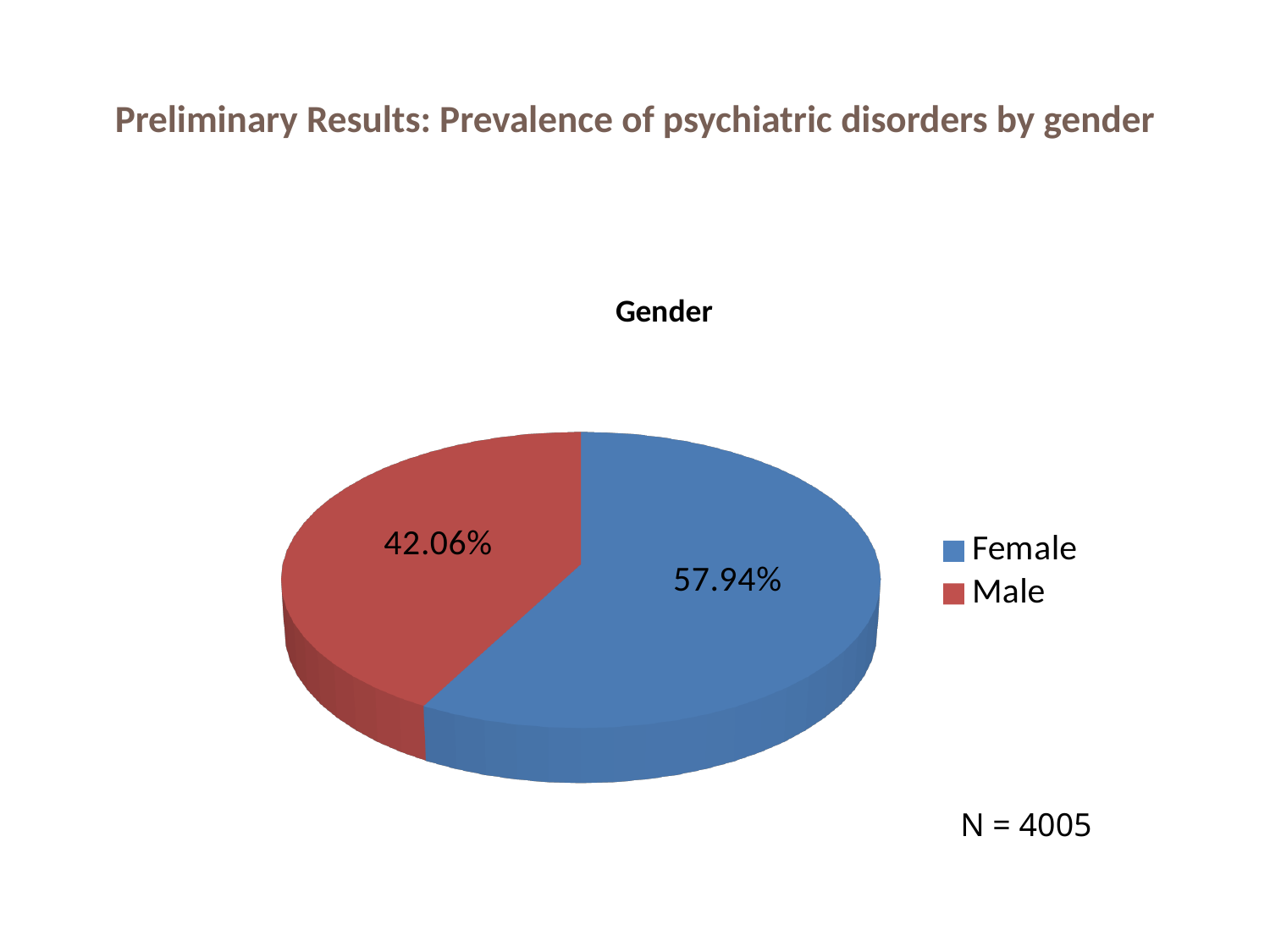
What is the sample size (N) shown on the slide? 4005 Which slice is the smallest? Male What is the title of the chart? Gender How many slices does the pie chart have? 2 What colour is the Male slice? red Which slice is the largest? Female Which is larger, the Female slice or the Male slice? Female What percentage of the pie is Female? 57.94% What type of chart is shown on the slide? pie chart How many entries does the legend list? 2 What percentage of the pie is Male? 42.06% What is the difference in percentage points between the Female and Male slices? 15.88